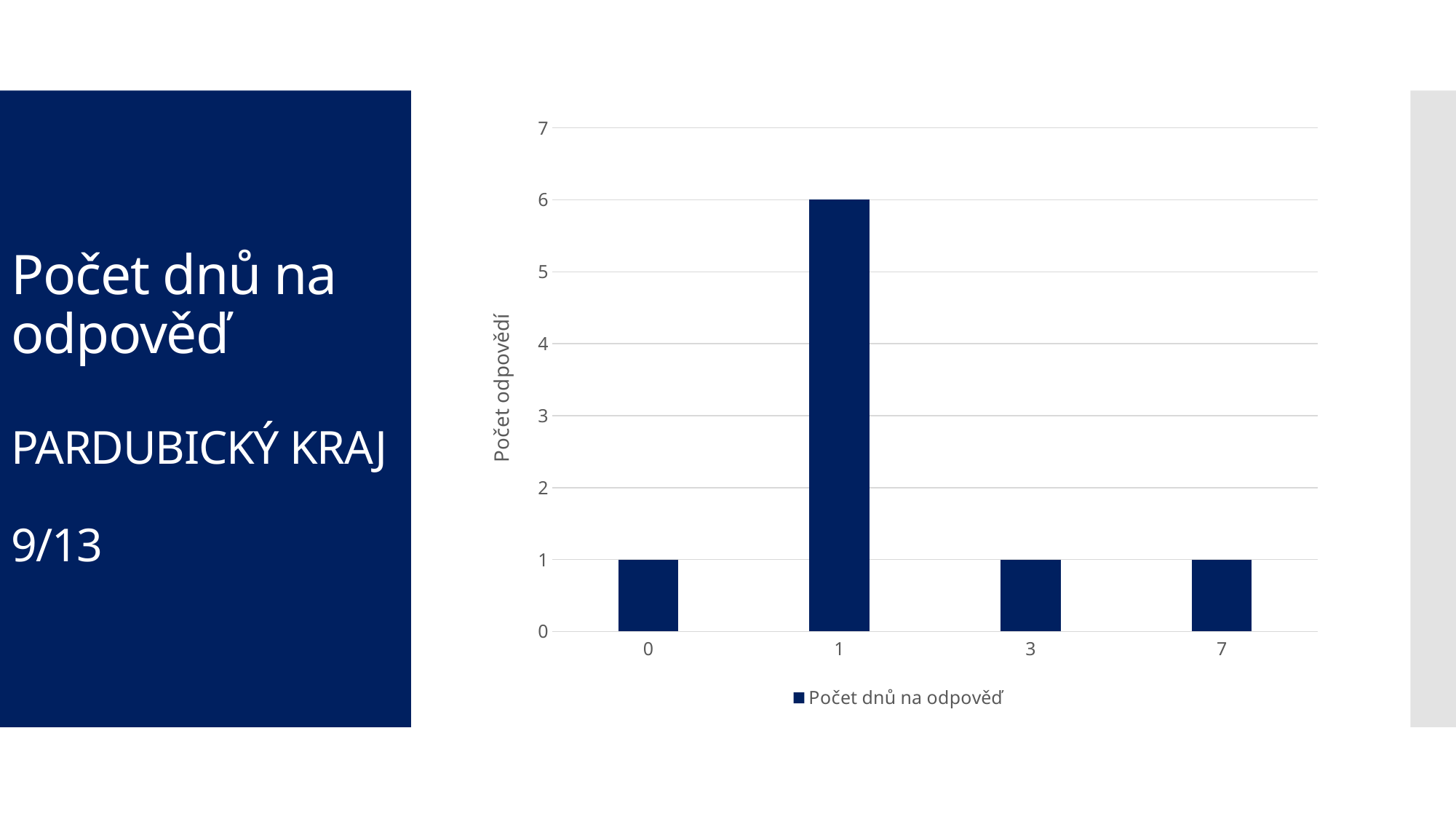
What is the value (Počet odpovědí) for category 1? 6 Which category has the highest value in the chart? 1 Which is larger: the value for category 1 or the value for category 7? category 1 How many series does the chart legend list? 1 What is the value (Počet odpovědí) for category 7? 1 What is the difference between the value for category 1 and the value for category 3? 5 What is the label of the vertical axis of the chart? Počet odpovědí What is the label of the series in the chart legend? Počet dnů na odpověď What kind of chart is shown on the slide? bar chart Is the value for category 1 greater or less than 5? greater How many categories are shown on the x axis of the chart? 4 What is the value (Počet odpovědí) for category 0? 1